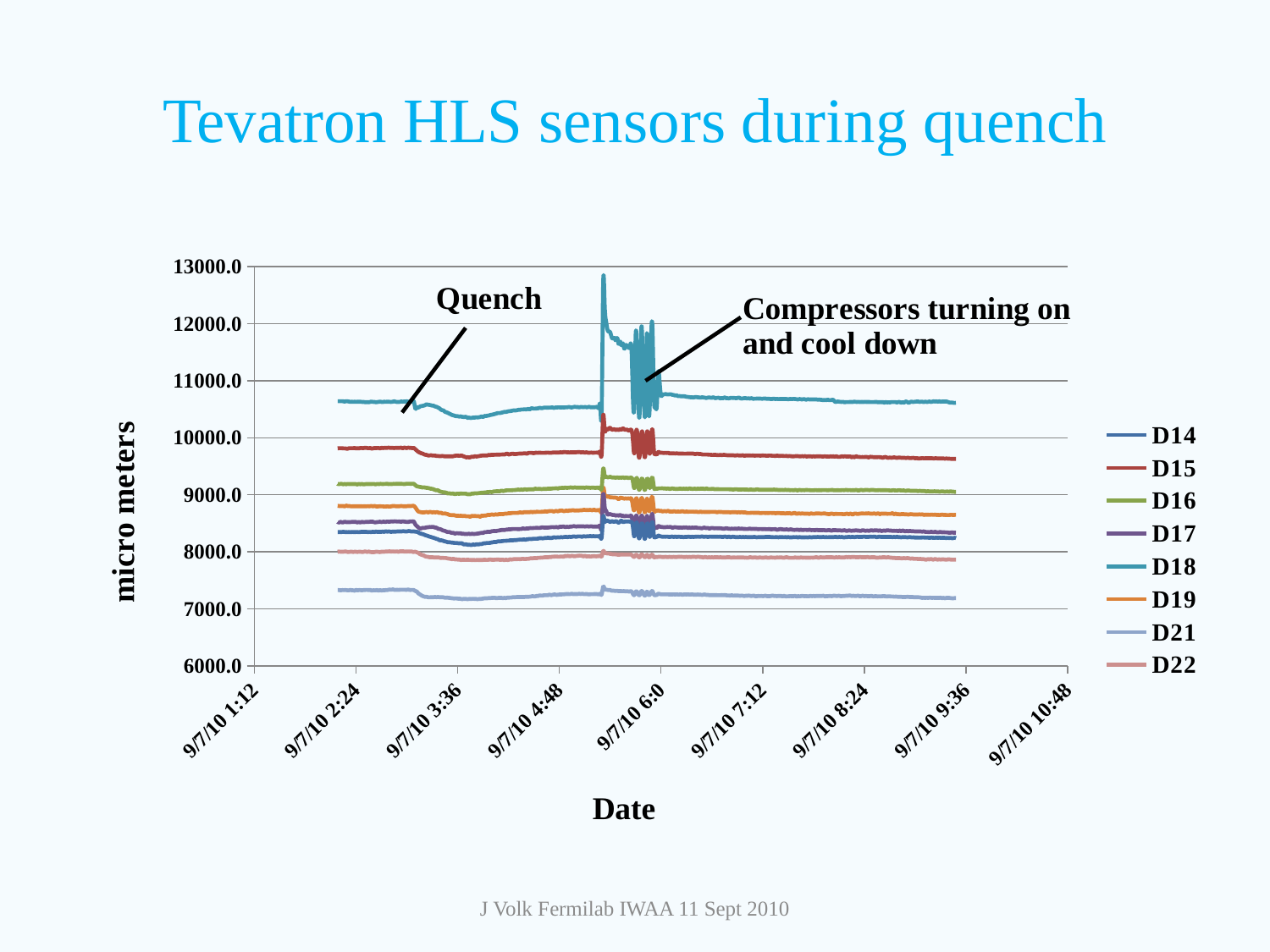
Which series has larger values, D15 or D16? D15 Is the value for D21 at 9/7/10 2:24 greater or less than 8000.0? less How many series does the legend list? 8 Is the value for D22 at 9/7/10 8:24 greater or less than 8000.0? less Which series has the lowest values throughout the chart? D21 What kind of chart is shown on the slide? line chart Which series has the highest values throughout the chart? D18 What is the label of the vertical axis? micro meters Is the value for D18 at 9/7/10 2:24 greater or less than 10000.0? greater What event does the annotation near 9/7/10 3:36 label? Quench Which series has larger values, D19 or D22? D19